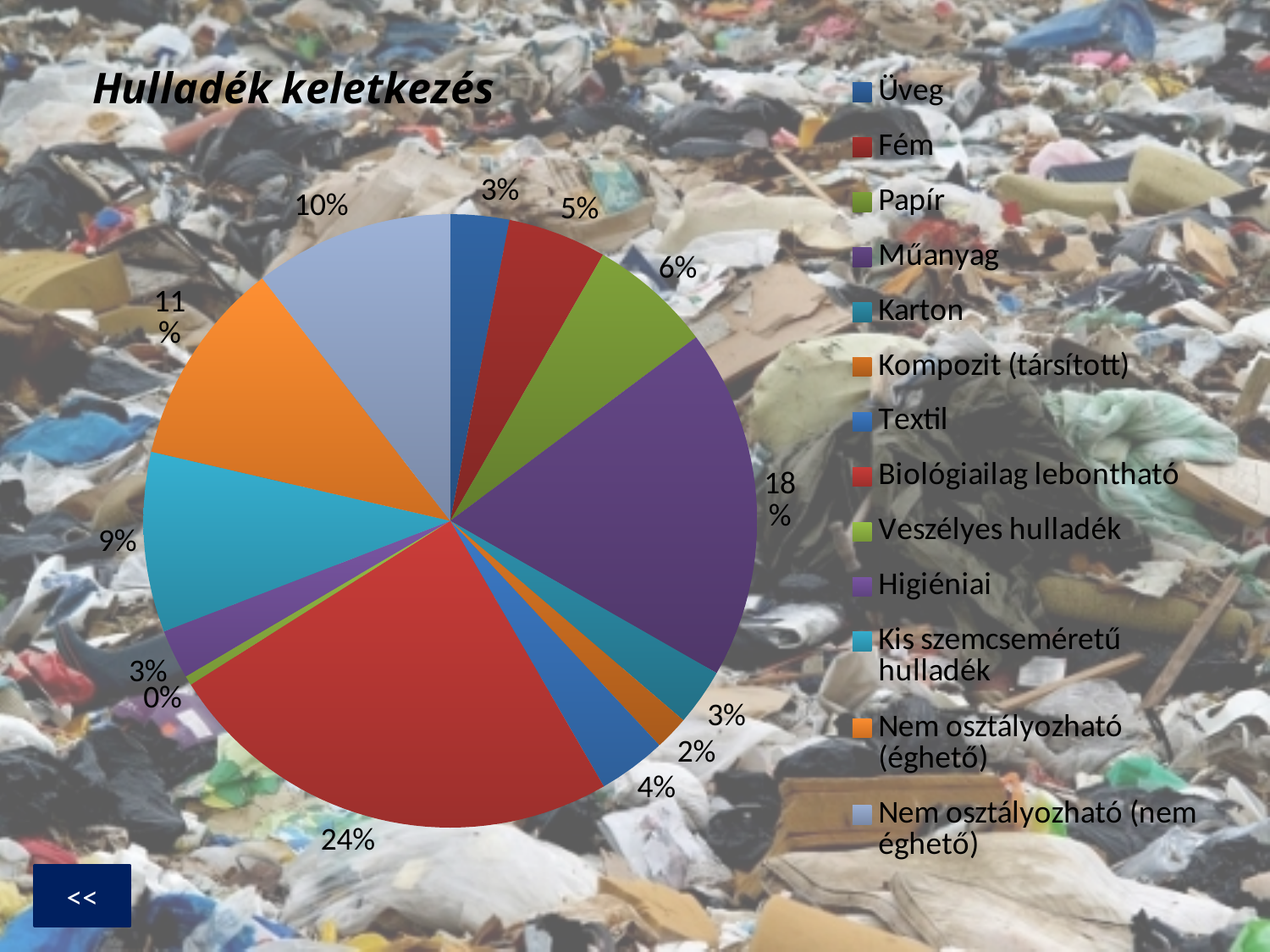
What is the title of the chart? Hulladék keletkezés How many categories does the legend of the pie chart list? 13 Which has a larger share, Nem osztályozható (éghető) or Nem osztályozható (nem éghető)? Nem osztályozható (éghető) Which category has the smallest share of the pie? Veszélyes hulladék What percentage is shown for Kompozit (társított)? 2% What share of the pie does Műanyag have? 18% What kind of chart is shown on the slide? pie chart What percentage is shown for Papír? 6% What is the difference in percentage points between Biológiailag lebontható and Műanyag? 6 What share of the pie does Biológiailag lebontható have? 24% Which category has the largest share of the pie? Biológiailag lebontható What percentage is shown for Kis szemcseméretű hulladék? 9%